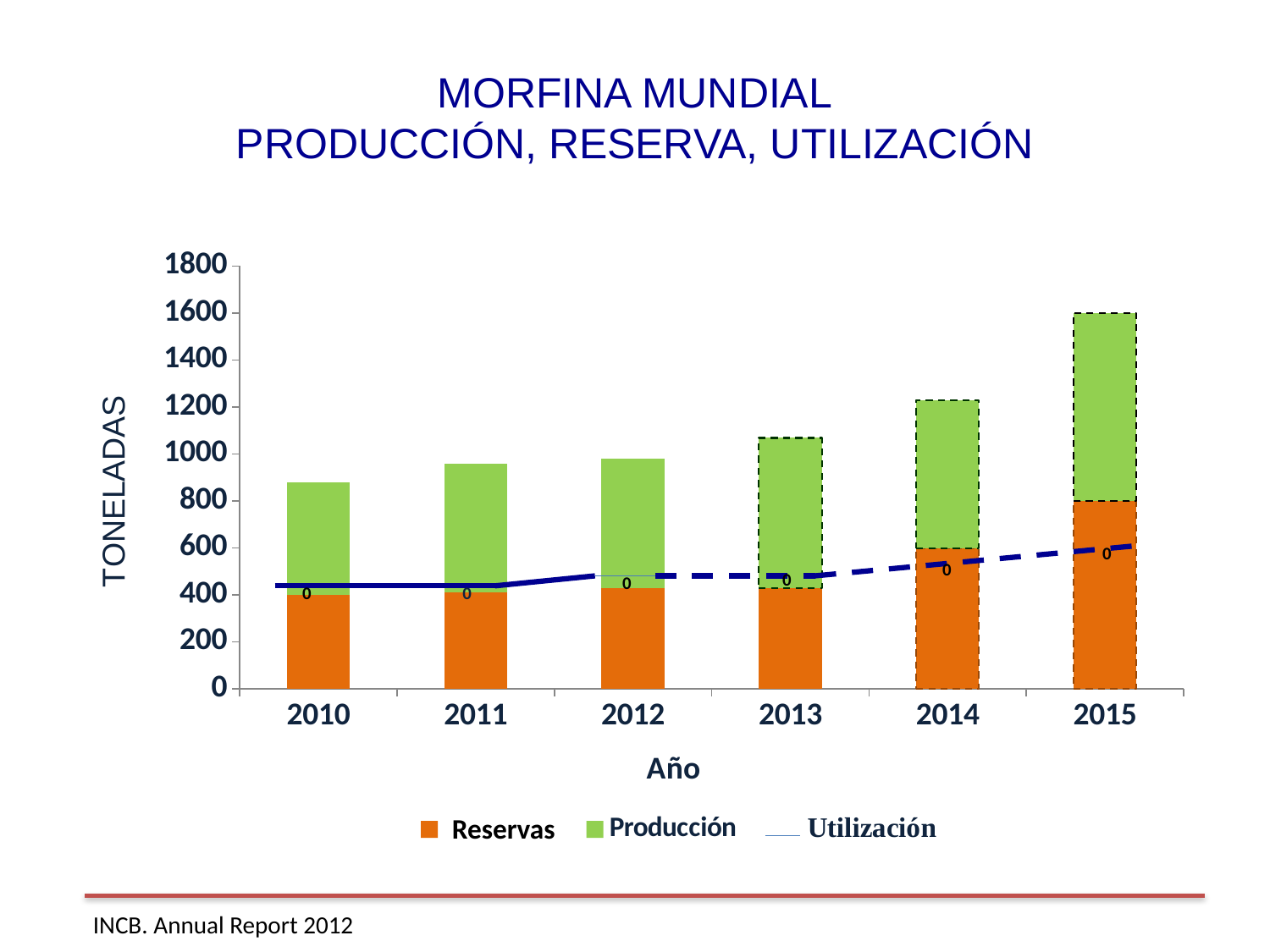
What is the label on the y axis of the chart? TONELADAS Which year has the shortest stacked bar? 2010 Is the total stacked bar for 2010 greater or less than 1000? less Is the Reservas value for 2015 greater or less than 600? greater Which year has the tallest stacked bar? 2015 What kind of chart is shown on the slide? Stacked bar chart with a line How many series does the legend list? 3 Is the total stacked bar for 2015 greater or less than 1400? greater Do the total stacked bar heights rise or fall from 2010 to 2015? rise Which year has the larger Reservas value, 2010 or 2015? 2015 What is the label on the x axis of the chart? Año How many years are shown on the x axis of the chart? 6